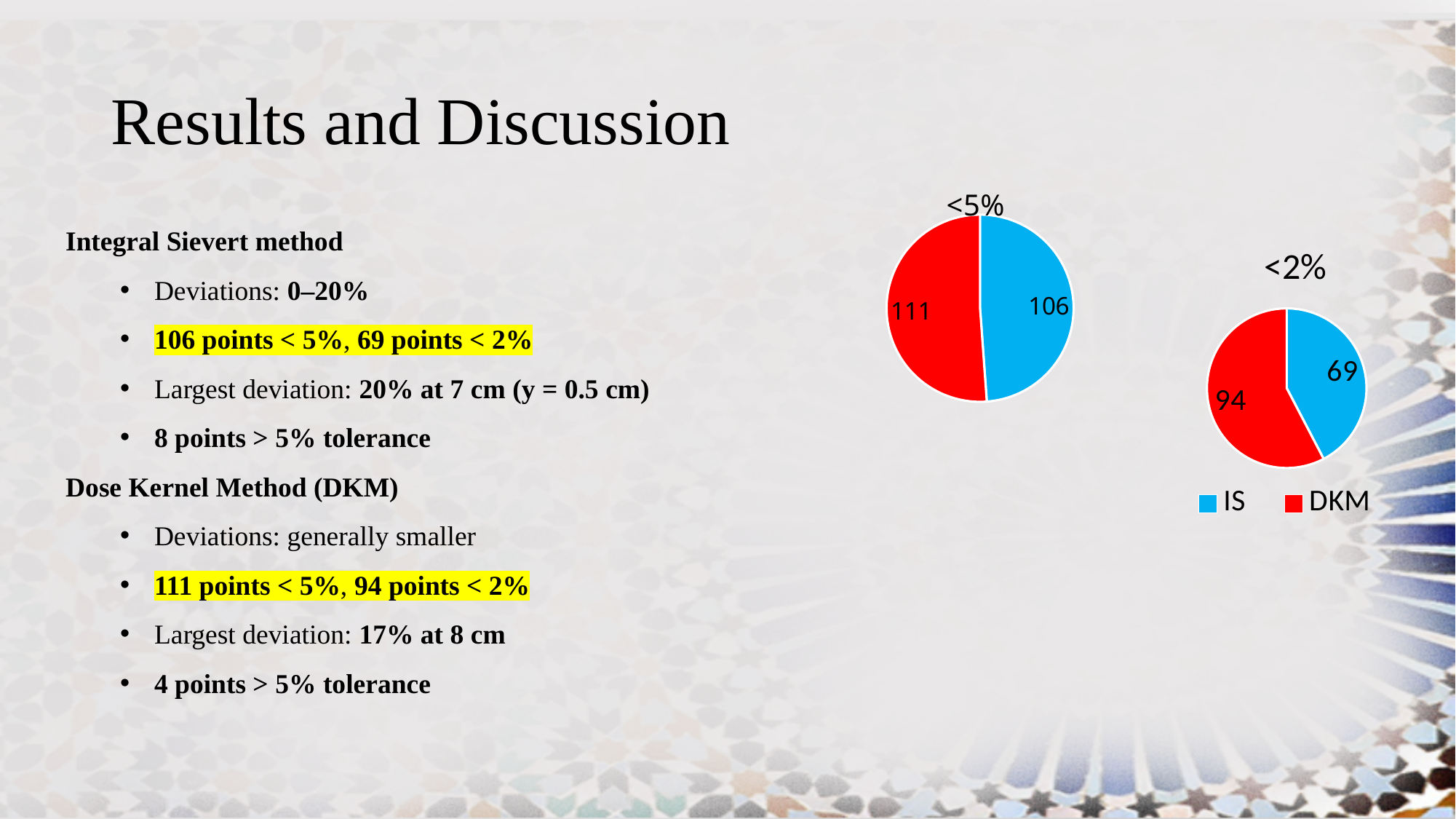
In the "<2%" pie chart, what is the value for DKM? 94 In the "<5%" pie chart, what is the value for IS? 106 In the "<5%" pie chart, what is the value for DKM? 111 In the "<2%" pie chart, what is the value for IS? 69 What type of chart is used for the "<5%" and "<2%" charts? Pie chart In the "<2%" pie chart, which slice is larger, IS or DKM? DKM In the "<2%" pie chart, what share of the total does DKM represent, to the nearest whole percent? 58% How many slices does the "<2%" pie chart have? 2 In the "<2%" pie chart, what is the difference between the DKM and IS values? 25 In the "<5%" pie chart, what is the total of the two slices? 217 Which colour represents DKM in the pie charts? Red In the "<5%" pie chart, what is the difference between the DKM and IS values? 5